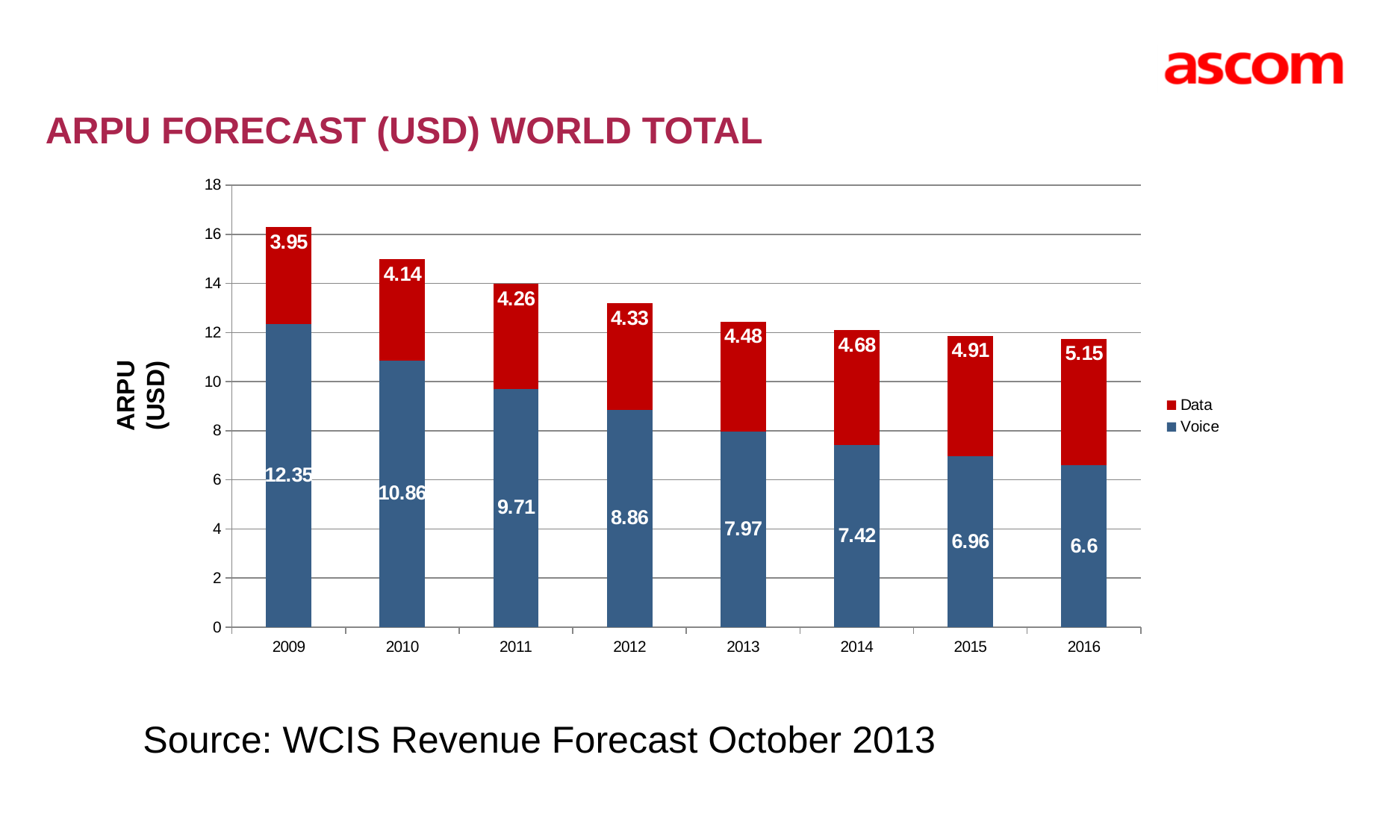
What is the total ARPU (Voice plus Data) for 2009? 16.3 Which is larger, the Data value in 2012 or the Data value in 2015? 2015 What is the difference between the Voice value in 2009 and the Voice value in 2016? 5.75 Which year has the lowest Voice value? 2016 What is the Voice ARPU value for 2009? 12.35 What kind of chart is shown on the slide? Stacked bar chart Which year has the highest Data value? 2016 What is the Voice value for 2013? 7.97 What is the total ARPU (Voice plus Data) for 2016? 11.75 How many series does the legend list? 2 How many years are shown on the x axis? 8 What is the Data ARPU value for 2016? 5.15